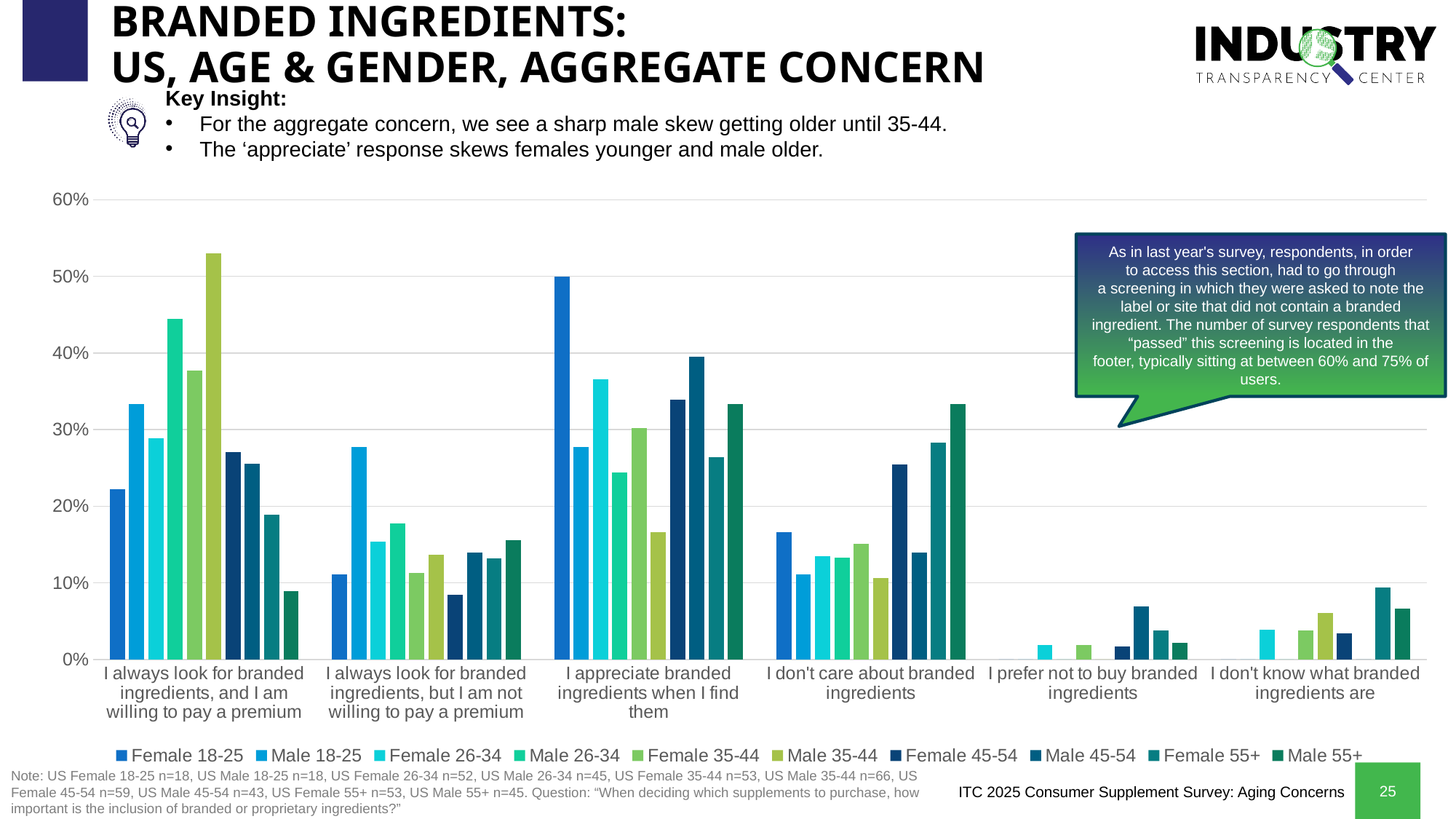
Is the value for Male 35-44 in 'I always look for branded ingredients, and I am willing to pay a premium' greater or less than 50%? greater Is the value for Male 35-44 in 'I appreciate branded ingredients when I find them' greater or less than 20%? less For 'I always look for branded ingredients, and I am willing to pay a premium', which is larger: Male 26-34 or Female 26-34? Male 26-34 What kind of chart is shown on the slide? bar chart Which series has the highest value for 'I always look for branded ingredients, and I am willing to pay a premium'? Male 35-44 Is the value for Male 18-25 in 'I always look for branded ingredients, but I am not willing to pay a premium' greater or less than 20%? greater How many series does the legend list? 10 For 'I don't care about branded ingredients', which is larger: Male 55+ or Female 18-25? Male 55+ How many response categories are shown along the x axis? 6 What is the title of the slide containing the chart? BRANDED INGREDIENTS: US, AGE & GENDER, AGGREGATE CONCERN Which series has the lowest value for 'I always look for branded ingredients, and I am willing to pay a premium'? Male 55+ Which series has the highest value for 'I appreciate branded ingredients when I find them'? Female 18-25